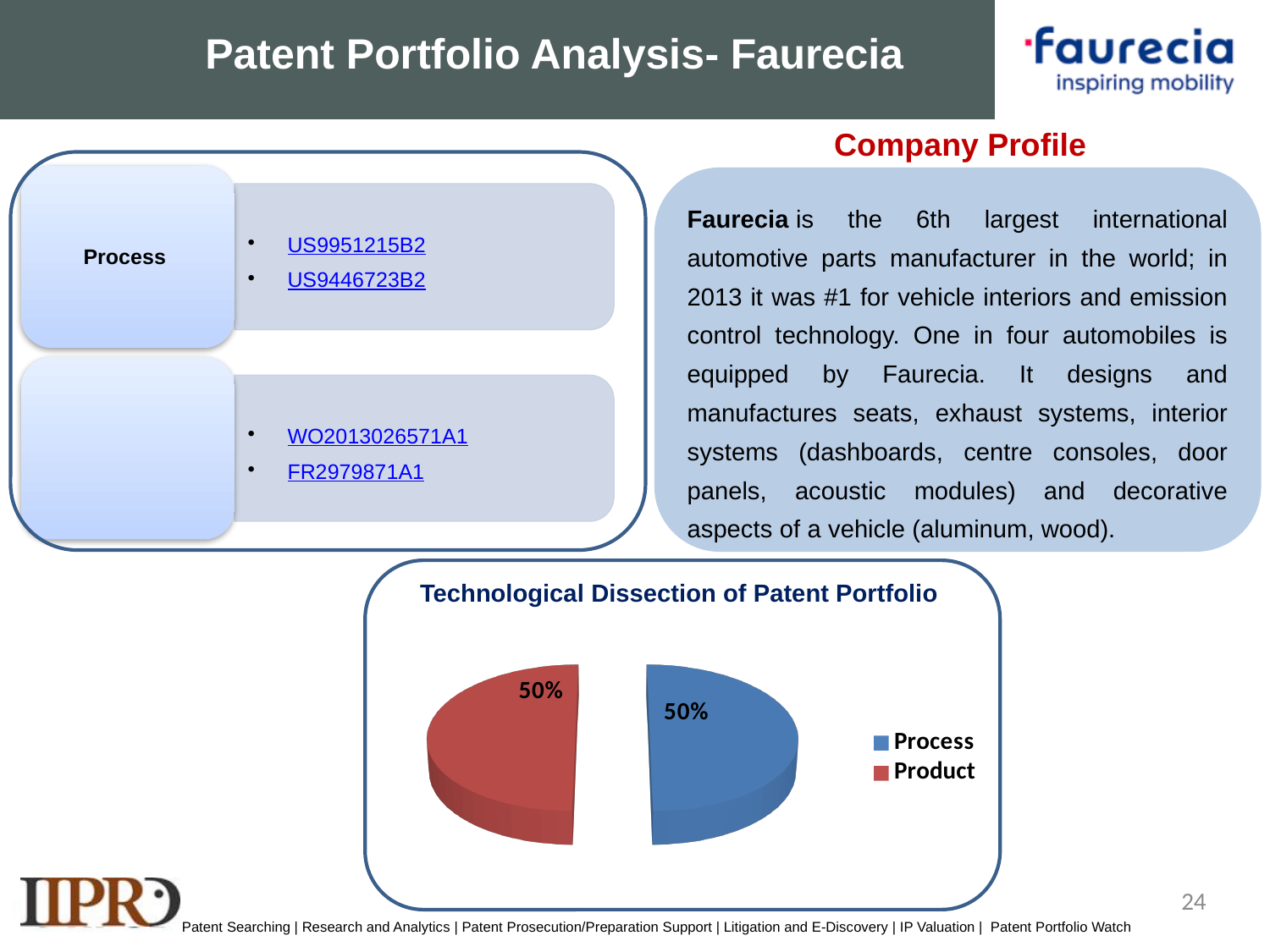
What is the combined share of the Process and Product slices in the pie chart? 100% Which colour represents Product in the pie chart? red How many entries does the legend of the pie chart list? 2 What share of the pie chart does the Product slice represent? 50% How many slices does the pie chart have? 2 What share of the pie chart does the Process slice represent? 50% What is the difference between the Process and Product shares in the pie chart? 0% What is the title of the pie chart? Technological Dissection of Patent Portfolio What kind of chart is shown under the title 'Technological Dissection of Patent Portfolio'? pie chart